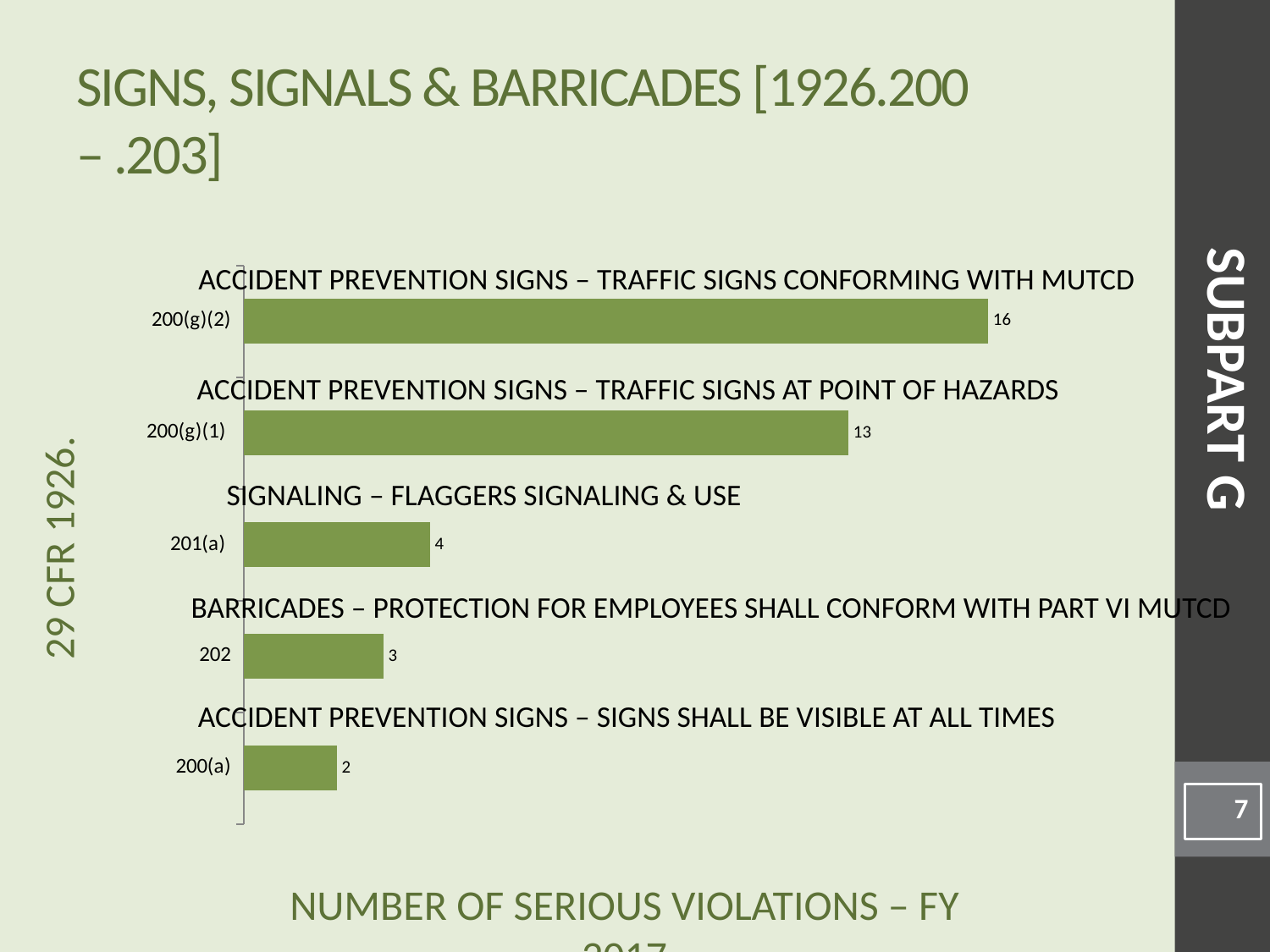
What is the title of the chart? NUMBER OF SERIOUS VIOLATIONS – FY 2017 Which category has the lowest number of serious violations? 200(a) What type of chart is shown on the slide? Bar chart Which category has the highest number of serious violations? 200(g)(2) What is the number of serious violations for 200(g)(2)? 16 What is the number of serious violations for 200(a)? 2 What is the number of serious violations for 202? 3 What is the number of serious violations for 200(g)(1)? 13 How many categories are shown in the chart? 5 What is the number of serious violations for 201(a)? 4 What is the difference between the values for 200(g)(2) and 200(g)(1)? 3 Which has more serious violations, 201(a) or 202? 201(a)